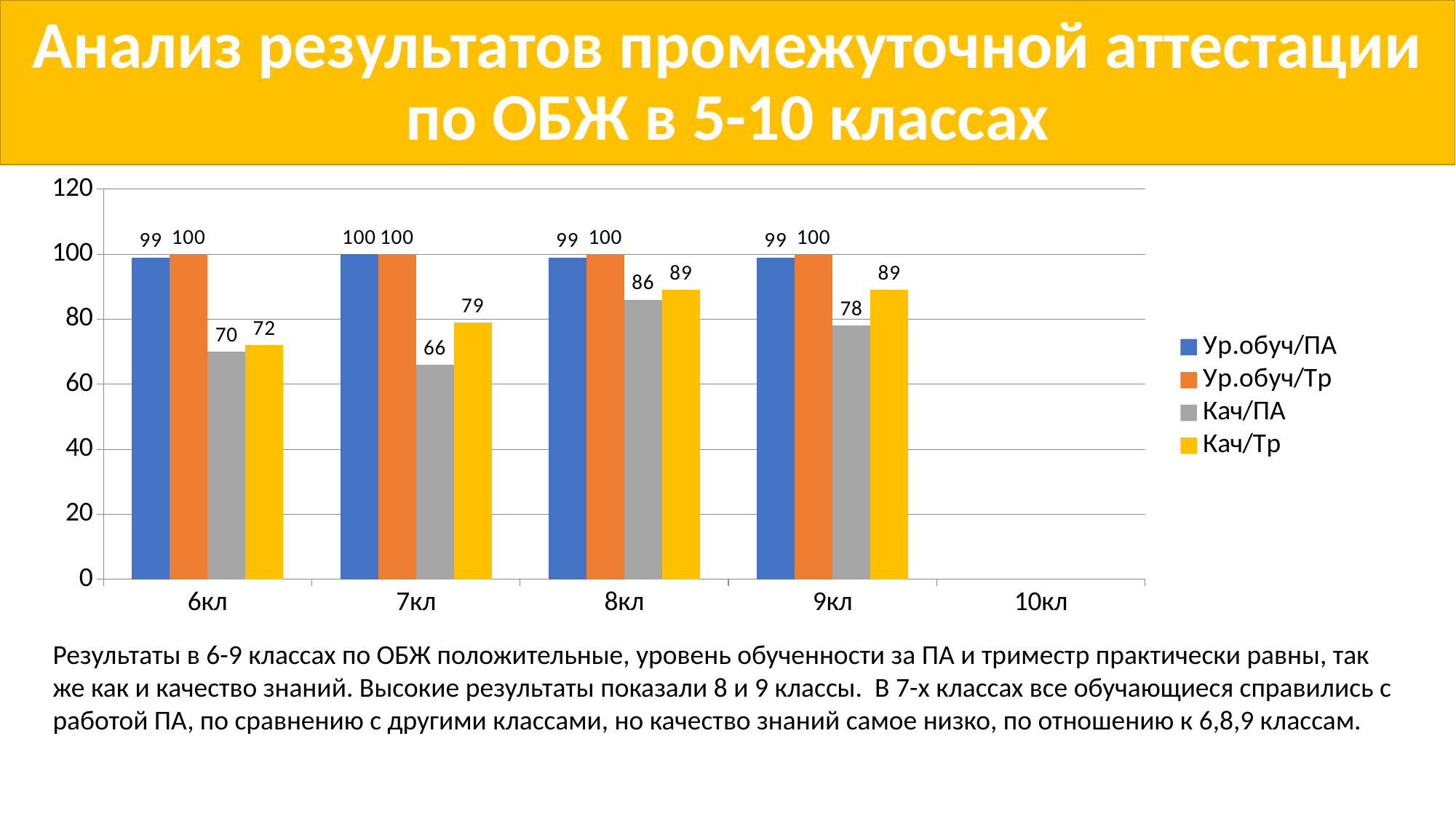
Which class has the lowest Кач/ПА value? 7кл Which class category on the x axis has no bars plotted? 10кл What is the value of Ур.обуч/ПА for 6кл? 99 Which class has the highest Кач/ПА value? 8кл What is the difference between Кач/Тр and Кач/ПА for 9кл? 11 What is the value of Кач/Тр for 8кл? 89 What is the value of Кач/ПА for 7кл? 66 How many series does the legend list? 4 How many class categories are labelled on the x axis? 5 What colour are the Кач/Тр bars? yellow What kind of chart is shown on the slide? bar chart Which is larger for 6кл: Кач/ПА or Кач/Тр? Кач/Тр